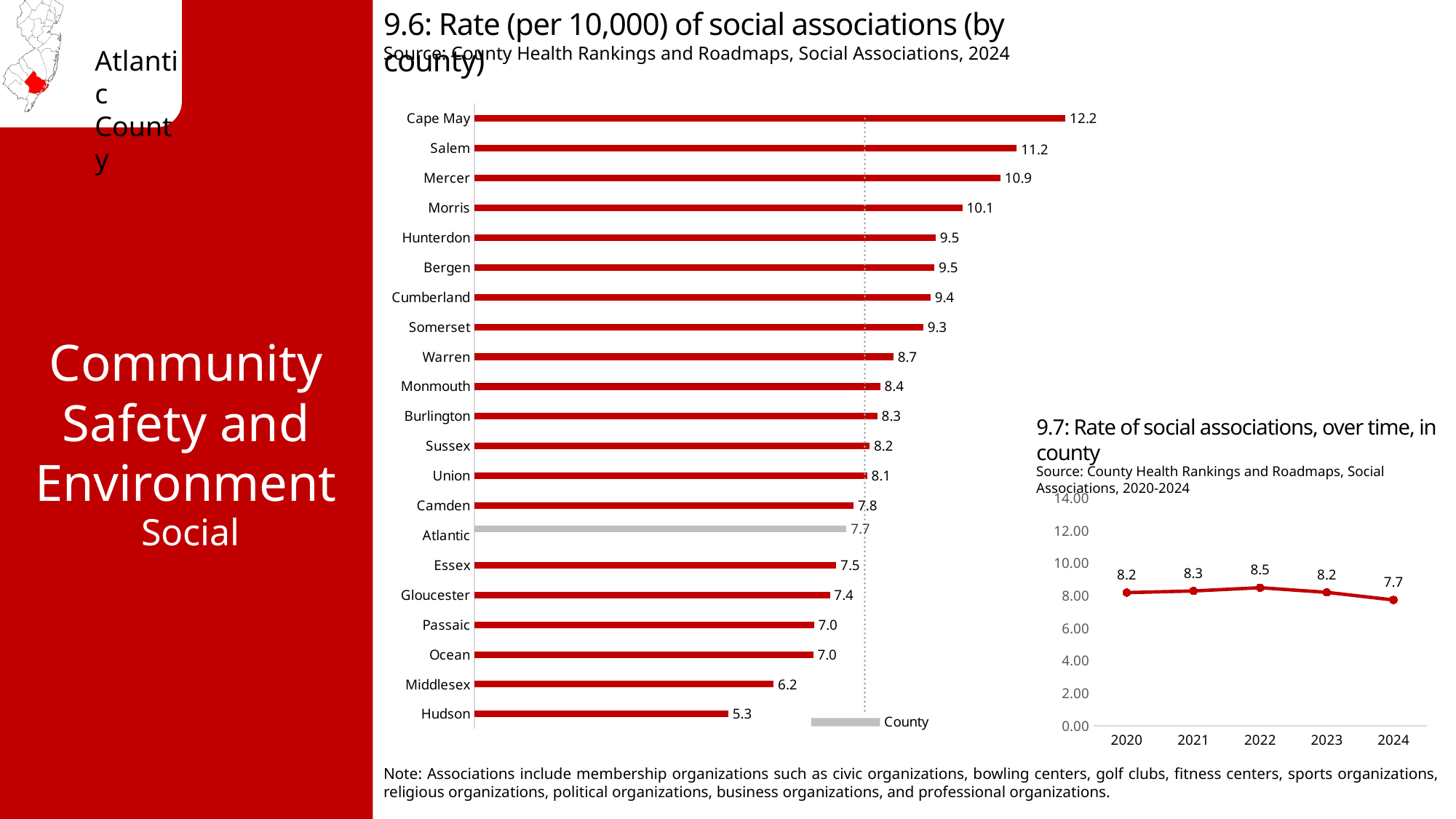
What kind of chart is chart 9.6 (rate of social associations by county)? Bar chart In chart 9.6 (rate of social associations by county), which county has the highest rate? Cape May In chart 9.6 (rate of social associations by county), which has a higher rate, Mercer or Morris? Mercer In chart 9.7 (rate of social associations over time), which year has the lowest value? 2024 In chart 9.7 (rate of social associations over time), what is the value for 2022? 8.5 In chart 9.6 (rate of social associations by county), what is the difference between Cape May and Hudson? 6.9 In chart 9.6 (rate of social associations by county), what is the value for Atlantic? 7.7 In chart 9.7 (rate of social associations over time), what is the difference between 2022 and 2024? 0.8 What kind of chart is chart 9.7 (rate of social associations over time)? Line chart In chart 9.6 (rate of social associations by county), how many counties are shown? 21 In chart 9.6 (rate of social associations by county), which county has the lowest rate? Hudson In chart 9.6 (rate of social associations by county), what is the value for Cape May? 12.2